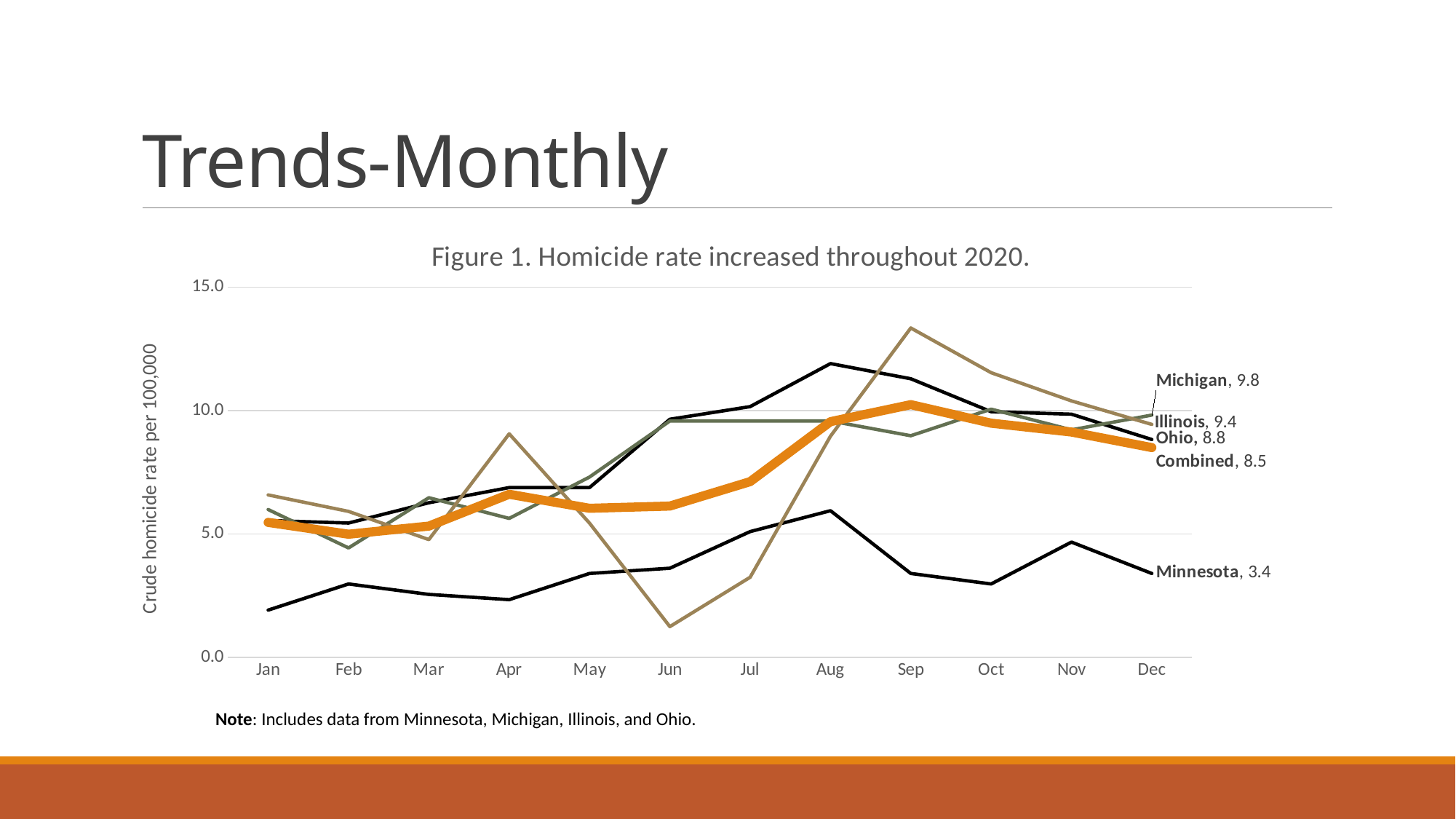
Which has the larger December value, Illinois or Ohio? Illinois What is the December value for Minnesota? 3.4 Which series has the highest labelled December value? Michigan Is the value for Minnesota in January greater or less than 5.0? less What is the December value for Ohio? 8.8 What is the y-axis title of the chart? Crude homicide rate per 100,000 What is the December value for Michigan? 9.8 What is the December value for the Combined series? 8.5 Which series has the lowest labelled December value? Minnesota What kind of chart is shown? Line chart How many months are shown on the x axis? 12 What is the difference between the December values for Michigan and Minnesota? 6.4